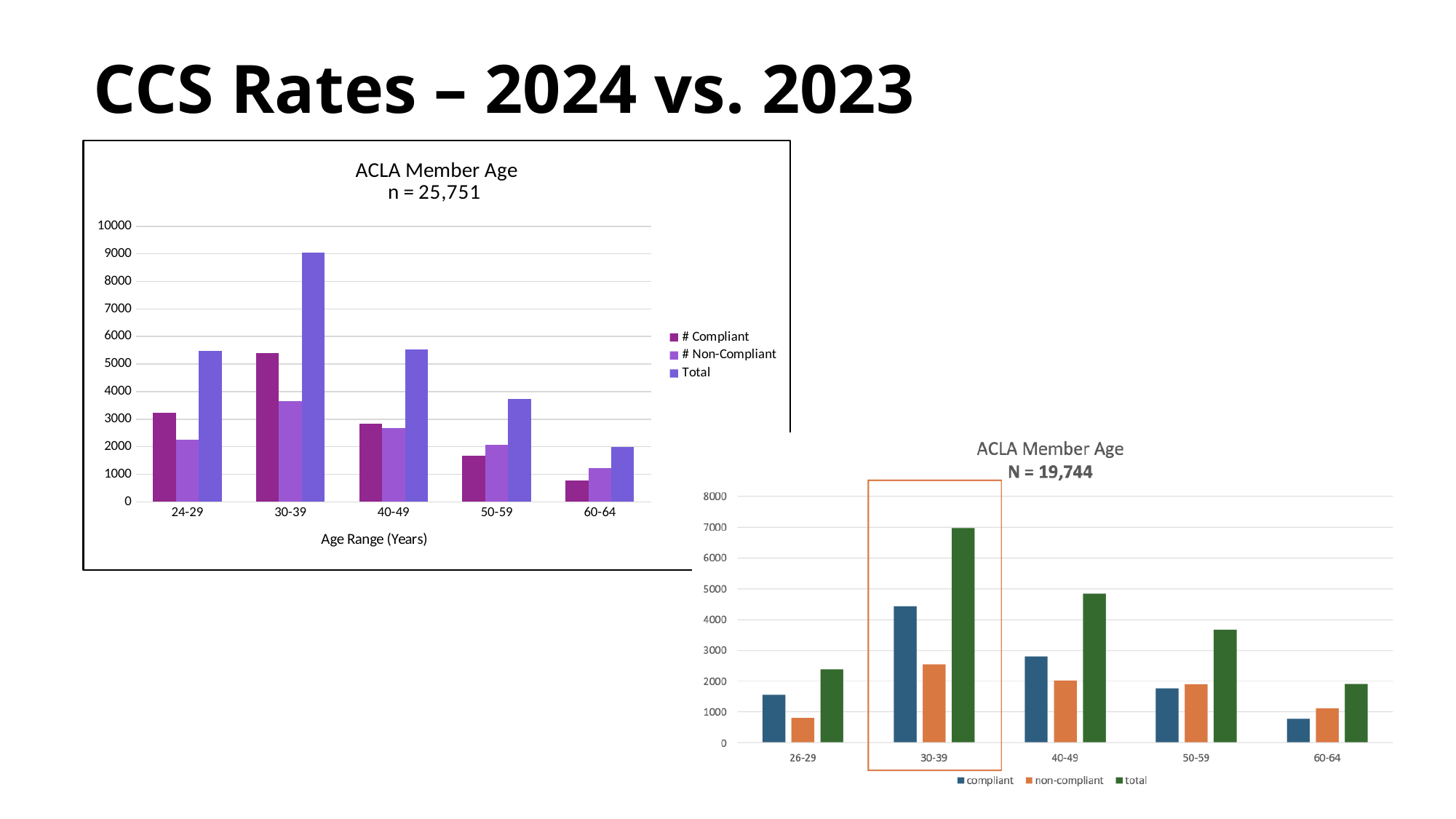
In the chart titled 'ACLA Member Age N = 19,744', how many age range categories are shown on the x axis? 5 In the chart titled 'ACLA Member Age n = 25,751', is the # Compliant value for 24-29 larger or smaller than the # Non-Compliant value for 24-29? larger In the chart titled 'ACLA Member Age n = 25,751', is the # Compliant value for 30-39 greater or less than 5000? greater In the chart titled 'ACLA Member Age n = 25,751', which age range has the highest Total? 30-39 In the chart titled 'ACLA Member Age N = 19,744', is the compliant value for 30-39 greater or less than 4000? greater In the chart titled 'ACLA Member Age n = 25,751', which age range has the lowest Total? 60-64 In the chart titled 'ACLA Member Age n = 25,751', is the Total for 30-39 greater or less than 8000? greater In the chart titled 'ACLA Member Age n = 25,751', how many series does the legend list? 3 In the chart titled 'ACLA Member Age N = 19,744', which age range has the highest total? 30-39 What kind of chart is the chart titled 'ACLA Member Age N = 19,744'? Bar chart In the chart titled 'ACLA Member Age n = 25,751', what is the x-axis title? Age Range (Years)